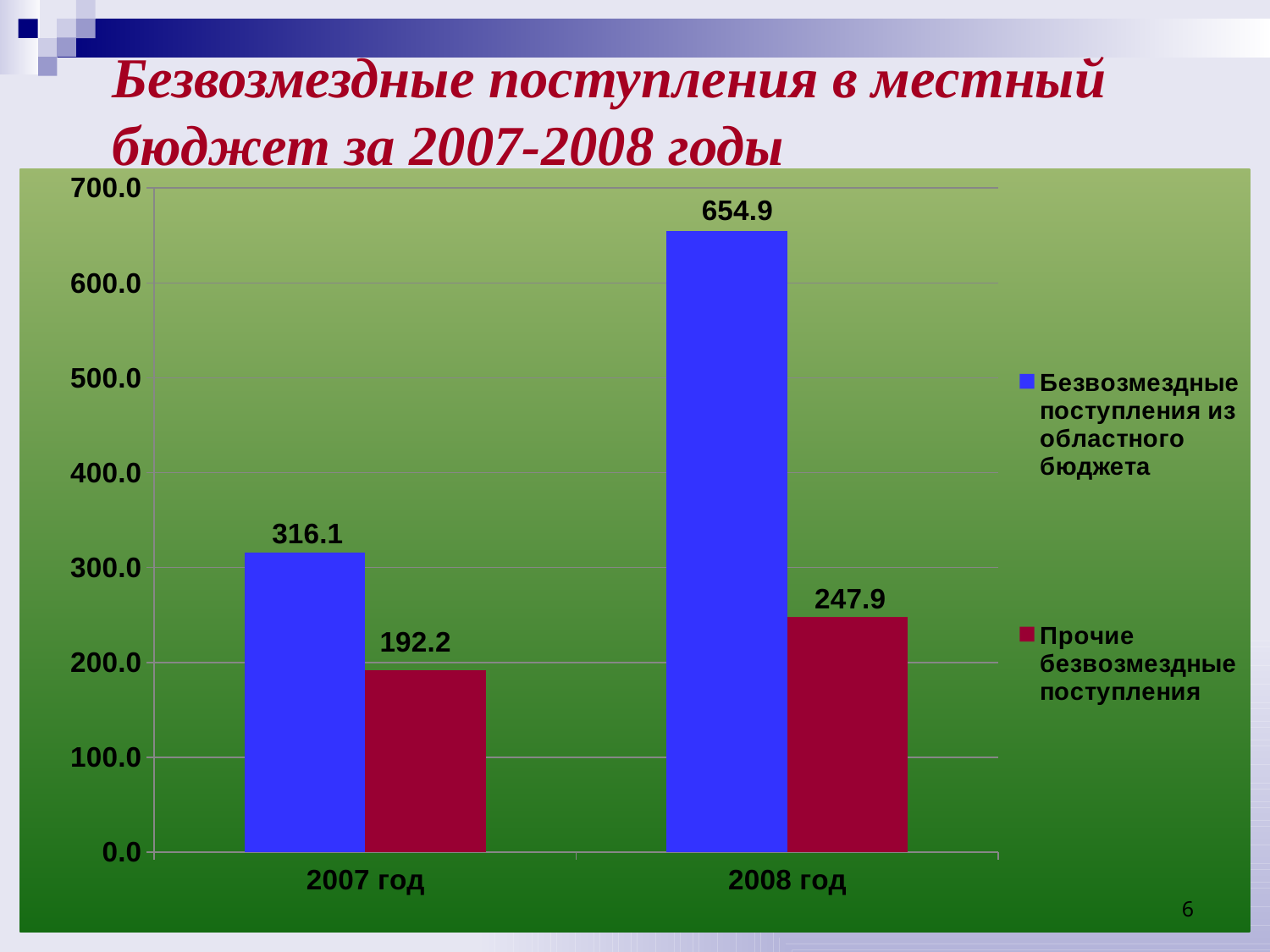
What is the difference between 'Безвозмездные поступления из областного бюджета' in 2008 год and 2007 год? 338.8 Do the values for 'Прочие безвозмездные поступления' rise or fall from 2007 год to 2008 год? Rise How many series does the legend list? 2 What kind of chart is shown on the slide? Bar chart Which year has the highest value for 'Безвозмездные поступления из областного бюджета'? 2008 год What is the value of 'Прочие безвозмездные поступления' for 2007 год? 192.2 Which year has the lowest value for 'Прочие безвозмездные поступления'? 2007 год How many year categories are shown on the x axis? 2 What is the value of 'Прочие безвозмездные поступления' for 2008 год? 247.9 Which is larger in 2008 год: 'Безвозмездные поступления из областного бюджета' or 'Прочие безвозмездные поступления'? Безвозмездные поступления из областного бюджета What is the value of 'Безвозмездные поступления из областного бюджета' for 2008 год? 654.9 What is the value of 'Безвозмездные поступления из областного бюджета' for 2007 год? 316.1